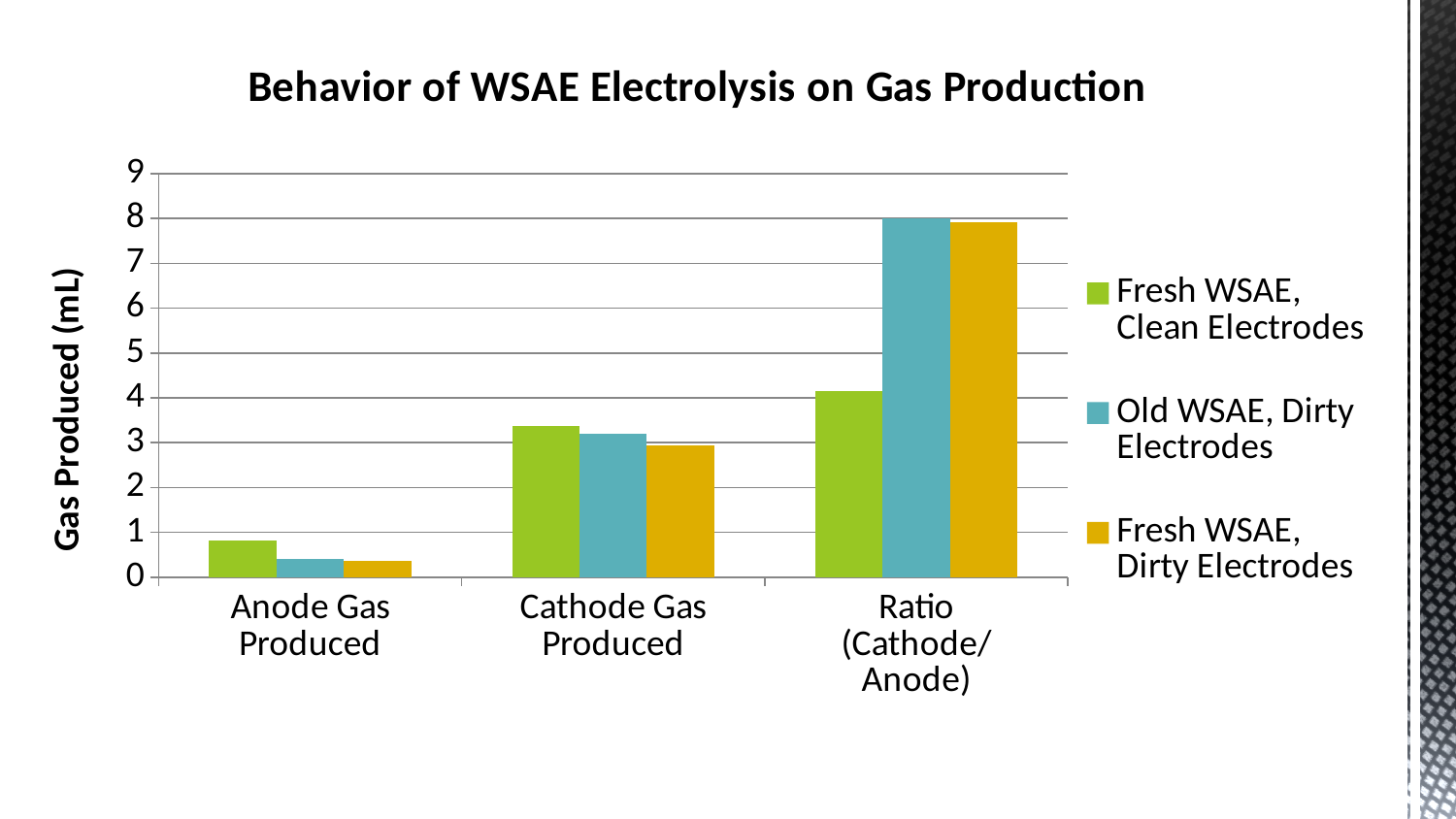
Is the value for Fresh WSAE, Clean Electrodes in Ratio (Cathode/Anode) greater or less than 5? less Is the value for Fresh WSAE, Clean Electrodes in Anode Gas Produced greater or less than 1? less How many categories are shown on the x axis of the chart? 3 For Anode Gas Produced, which is larger: the value for Fresh WSAE, Clean Electrodes or the value for Old WSAE, Dirty Electrodes? Fresh WSAE, Clean Electrodes How many series does the chart's legend list? 3 Which series has the highest value for Anode Gas Produced? Fresh WSAE, Clean Electrodes What is the label on the vertical axis of the chart? Gas Produced (mL) What kind of chart is shown on the slide? bar chart Is the value for Fresh WSAE, Dirty Electrodes in Ratio (Cathode/Anode) greater or less than 7? greater Which series has the lowest value for Cathode Gas Produced? Fresh WSAE, Dirty Electrodes Which series has the lowest value for Ratio (Cathode/Anode)? Fresh WSAE, Clean Electrodes What is the title of the chart? Behavior of WSAE Electrolysis on Gas Production